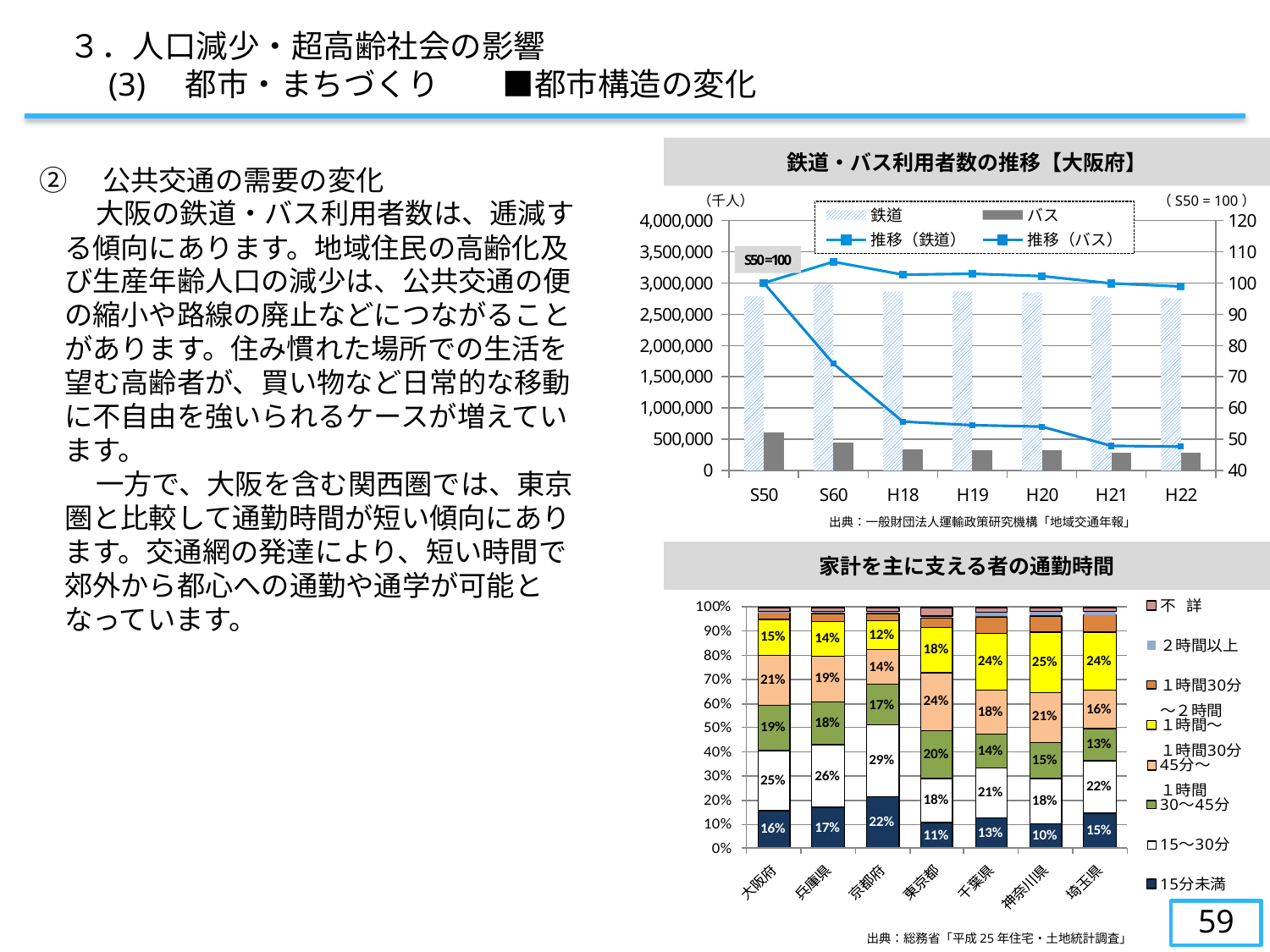
In the chart titled 家計を主に支える者の通勤時間, which prefecture has the lowest 15分未満 share? 神奈川県 In the chart titled 鉄道・バス利用者数の推移【大阪府】, what kind of chart is it? A combined bar and line chart In the chart titled 鉄道・バス利用者数の推移【大阪府】, how many time points are shown on the x axis? 7 In the chart titled 家計を主に支える者の通勤時間, what is the 15分未満 share for 京都府? 22% In the chart titled 鉄道・バス利用者数の推移【大阪府】, is the バス bar for S50 greater or less than 1,000,000? less In the chart titled 家計を主に支える者の通勤時間, how many series does the legend list? 8 In the chart titled 家計を主に支える者の通勤時間, how much larger is the 1時間～1時間30分 share for 神奈川県 than for 大阪府? 10 percentage points In the chart titled 鉄道・バス利用者数の推移【大阪府】, how many series does the legend list? 4 In the chart titled 鉄道・バス利用者数の推移【大阪府】, does the 推移（バス） line rise or fall from S50 to H22? fall In the chart titled 家計を主に支える者の通勤時間, which prefecture has the highest 15分未満 share? 京都府 In the chart titled 鉄道・バス利用者数の推移【大阪府】, is the 鉄道 bar for S50 greater or less than 2,500,000? greater In the chart titled 家計を主に支える者の通勤時間, what is the 15～30分 share for 京都府? 29%